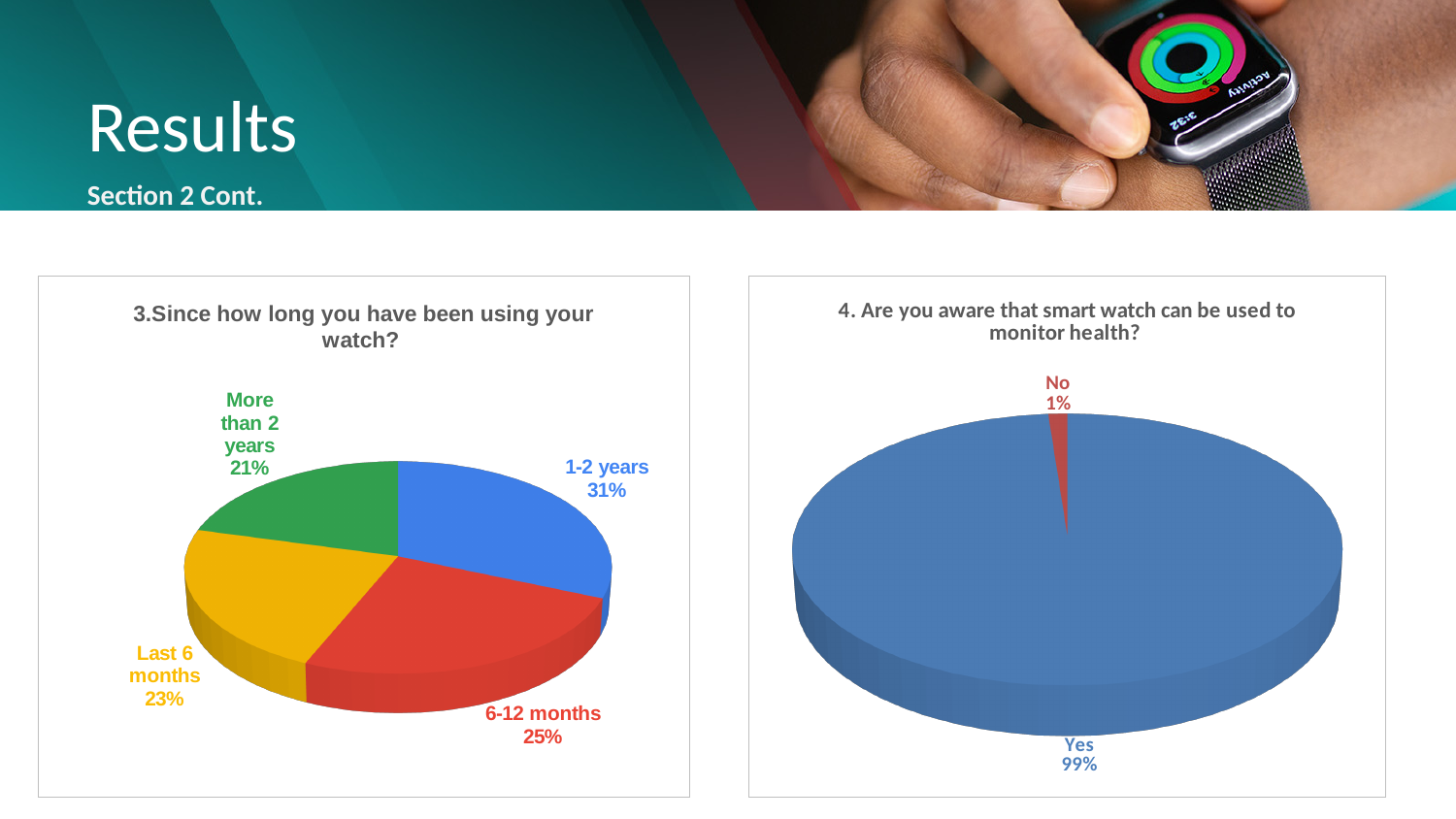
In the chart titled "4. Are you aware that smart watch can be used to monitor health?", what percentage of respondents answered "Yes"? 99% In the chart titled "3.Since how long you have been using your watch?", what percentage of respondents have been using their watch for 1-2 years? 31% In the chart titled "3.Since how long you have been using your watch?", which category has the largest share? 1-2 years In the chart titled "3.Since how long you have been using your watch?", what percentage of respondents chose "Last 6 months"? 23% How many categories are shown in the chart titled "4. Are you aware that smart watch can be used to monitor health?"? 2 In the chart titled "3.Since how long you have been using your watch?", what is the difference in percentage points between "1-2 years" and "6-12 months"? 6 What type of chart is the chart titled "3.Since how long you have been using your watch?"? Pie chart In the chart titled "3.Since how long you have been using your watch?", which category has the smallest share? More than 2 years In the chart titled "4. Are you aware that smart watch can be used to monitor health?", what percentage of respondents answered "No"? 1% In the chart titled "3.Since how long you have been using your watch?", what colour is the "More than 2 years" slice? Green How many categories are shown in the chart titled "3.Since how long you have been using your watch?"? 4 In the chart titled "3.Since how long you have been using your watch?", which is larger: "Last 6 months" or "6-12 months"? 6-12 months